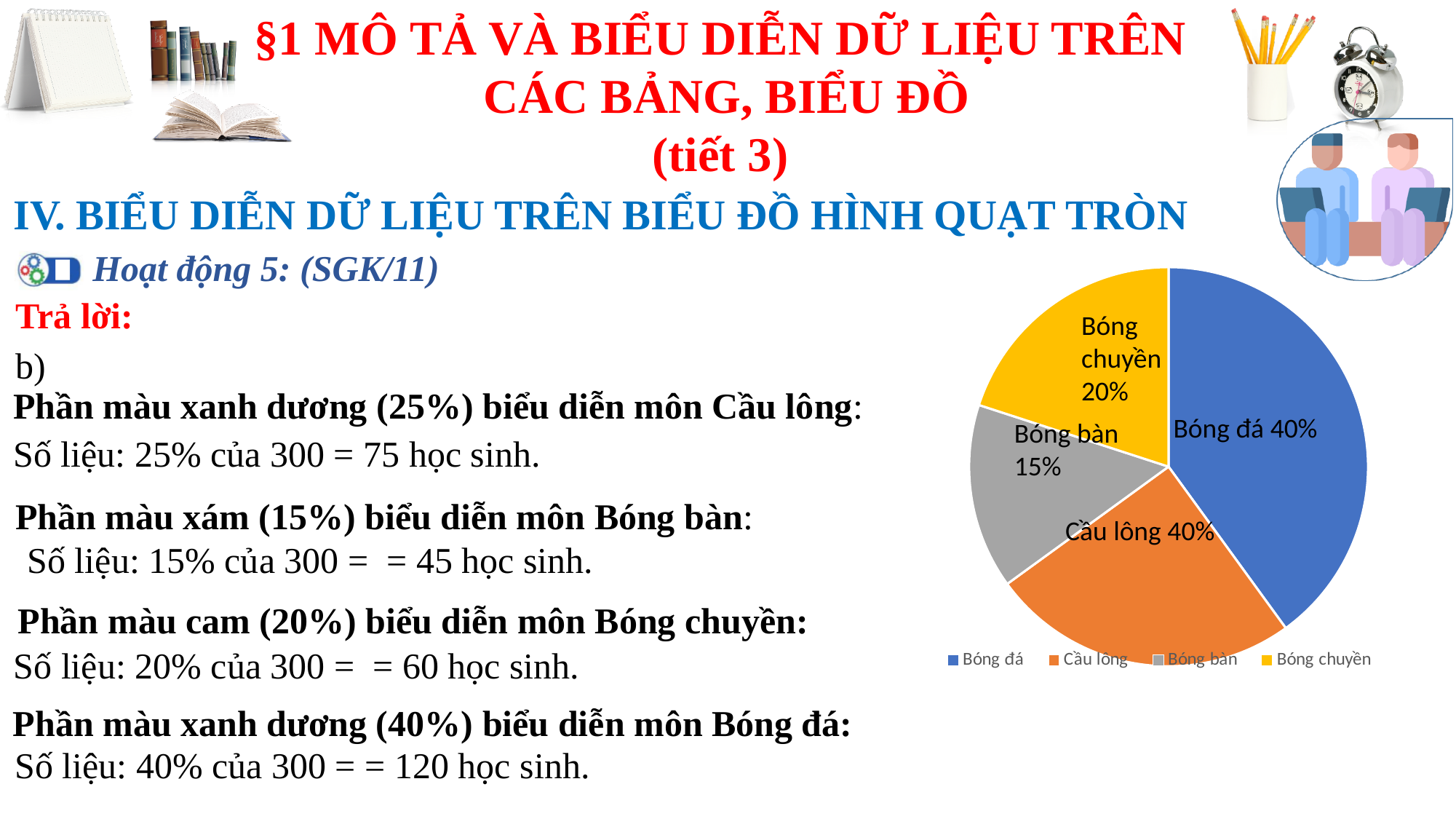
What kind of chart is shown on the slide? pie chart Which slice is larger in the pie chart, Bóng chuyền or Bóng bàn? Bóng chuyền How many entries does the legend of the pie chart list? 4 How many slices does the pie chart have? 4 What percentage is shown for Bóng đá in the pie chart? 40% What colour is the Bóng đá slice in the pie chart? blue What percentage is shown for Bóng chuyền in the pie chart? 20% Which slice is larger in the pie chart, Bóng đá or Bóng bàn? Bóng đá What is the difference in percentage points between the Bóng chuyền slice and the Bóng bàn slice? 5 What colour is the Bóng chuyền slice in the pie chart? yellow Which category has the smallest slice in the pie chart? Bóng bàn What percentage is shown for Bóng bàn in the pie chart? 15%